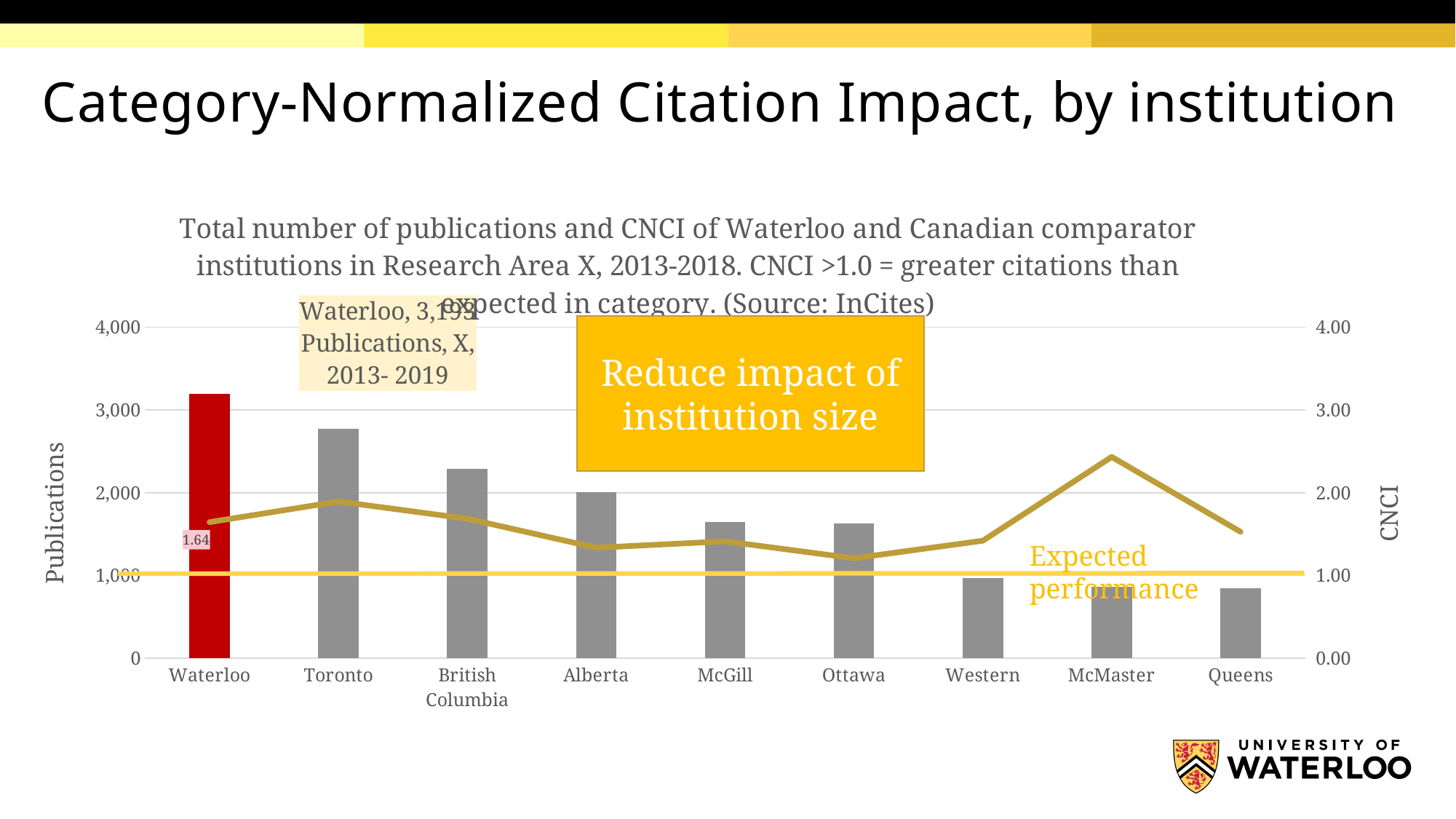
Which institution has the tallest publications bar? Waterloo Is the number of publications for Toronto greater or less than 2,000? greater Which institution has the lowest CNCI on the line? Ottawa What is the label on the right-hand vertical axis? CNCI Which institution has the highest CNCI on the line? McMaster At what CNCI value is the horizontal 'Expected performance' line drawn? 1.00 Is the CNCI value for McMaster greater or less than 2.00? greater What is the CNCI value labelled for Waterloo? 1.64 How many institutions are shown along the x axis? 9 What kind of chart is shown on the slide? A combined bar and line chart Which has more publications, Toronto or British Columbia? Toronto